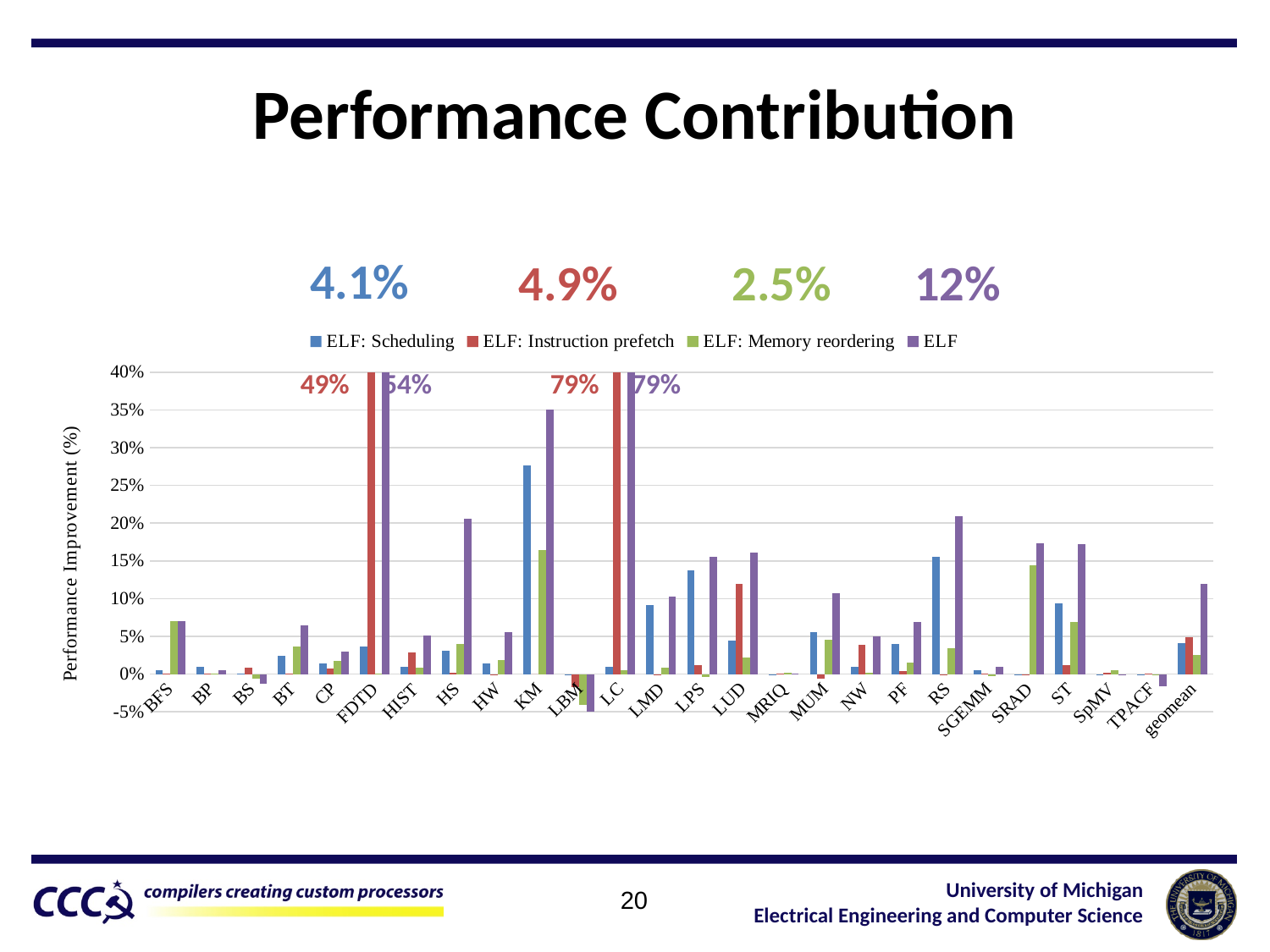
What is the geomean value for the ELF series? 12% How many series does the legend list? 4 What is the difference between the ELF value for LC and the ELF value for FDTD? 25 percentage points Which of the four series has the lowest geomean value? ELF: Memory reordering What is the ELF value for FDTD? 54% Which category has the highest ELF value? LC Is the ELF: Scheduling value for KM greater or less than 25%? greater How many categories are shown along the x axis? 26 What kind of chart is shown on the slide? bar chart What is the ELF: Instruction prefetch value for LC? 79% What is the geomean value for ELF: Instruction prefetch? 4.9% What is the y-axis title of the chart? Performance Improvement (%)